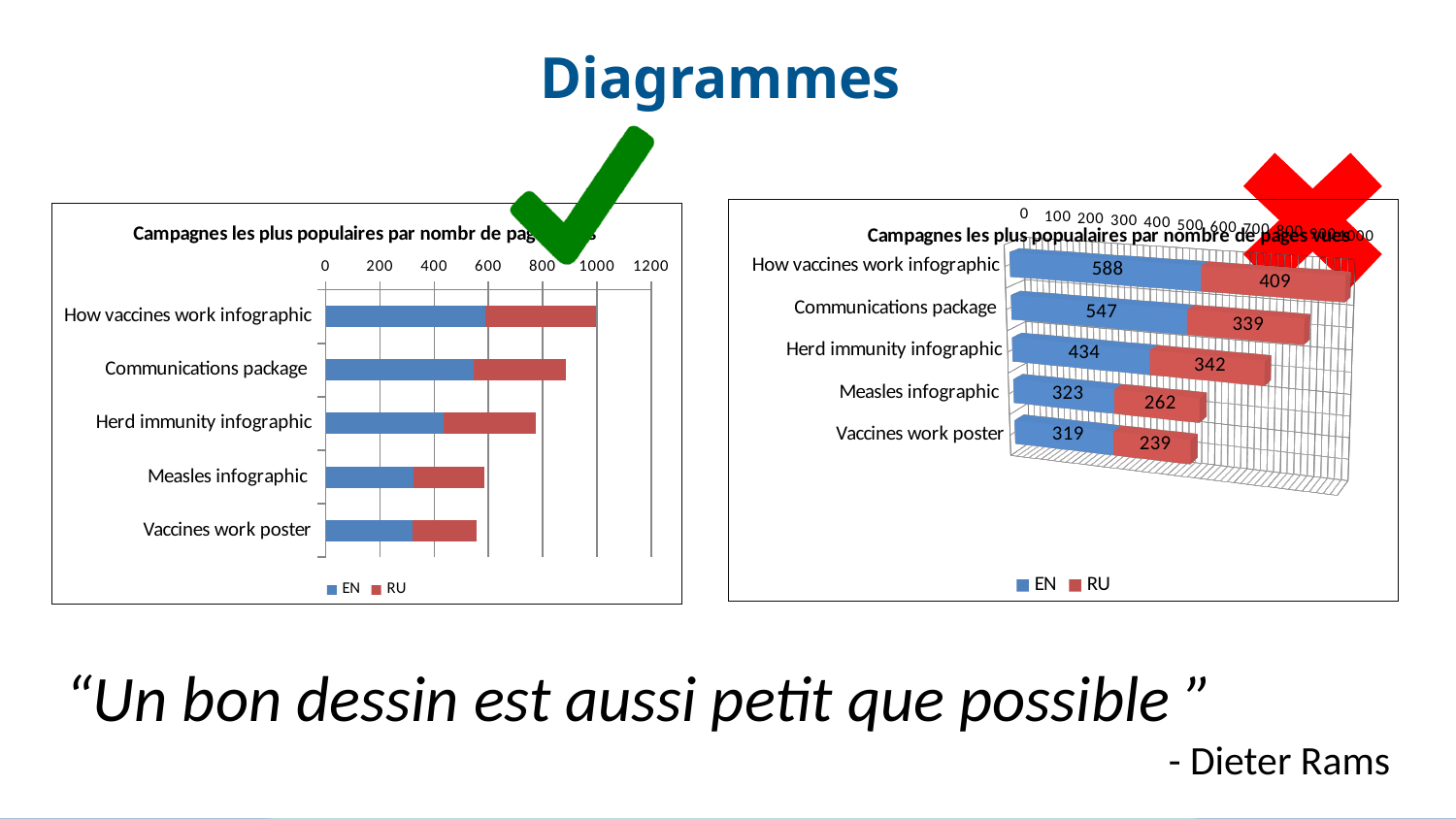
In the left-hand chart, is the total value for Vaccines work poster greater or less than 600? less In the right-hand chart, what is the total of the stacked bar for Measles infographic? 585 In the right-hand chart, what is the RU value for Vaccines work poster? 239 In the right-hand chart, which category has the lowest RU value? Vaccines work poster In the right-hand chart, what is the difference between the EN and RU values for Communications package? 208 In the left-hand chart, is the total value for Communications package greater or less than 800? greater In the right-hand chart, which category has the highest EN value? How vaccines work infographic How many series does the legend of the right-hand chart list? 2 In the right-hand chart, what is the EN value for How vaccines work infographic? 588 How many categories are shown in the left-hand chart? 5 In the right-hand chart, what is the RU value for Herd immunity infographic? 342 In the right-hand chart, is the RU value for Communications package or for Herd immunity infographic larger? Herd immunity infographic